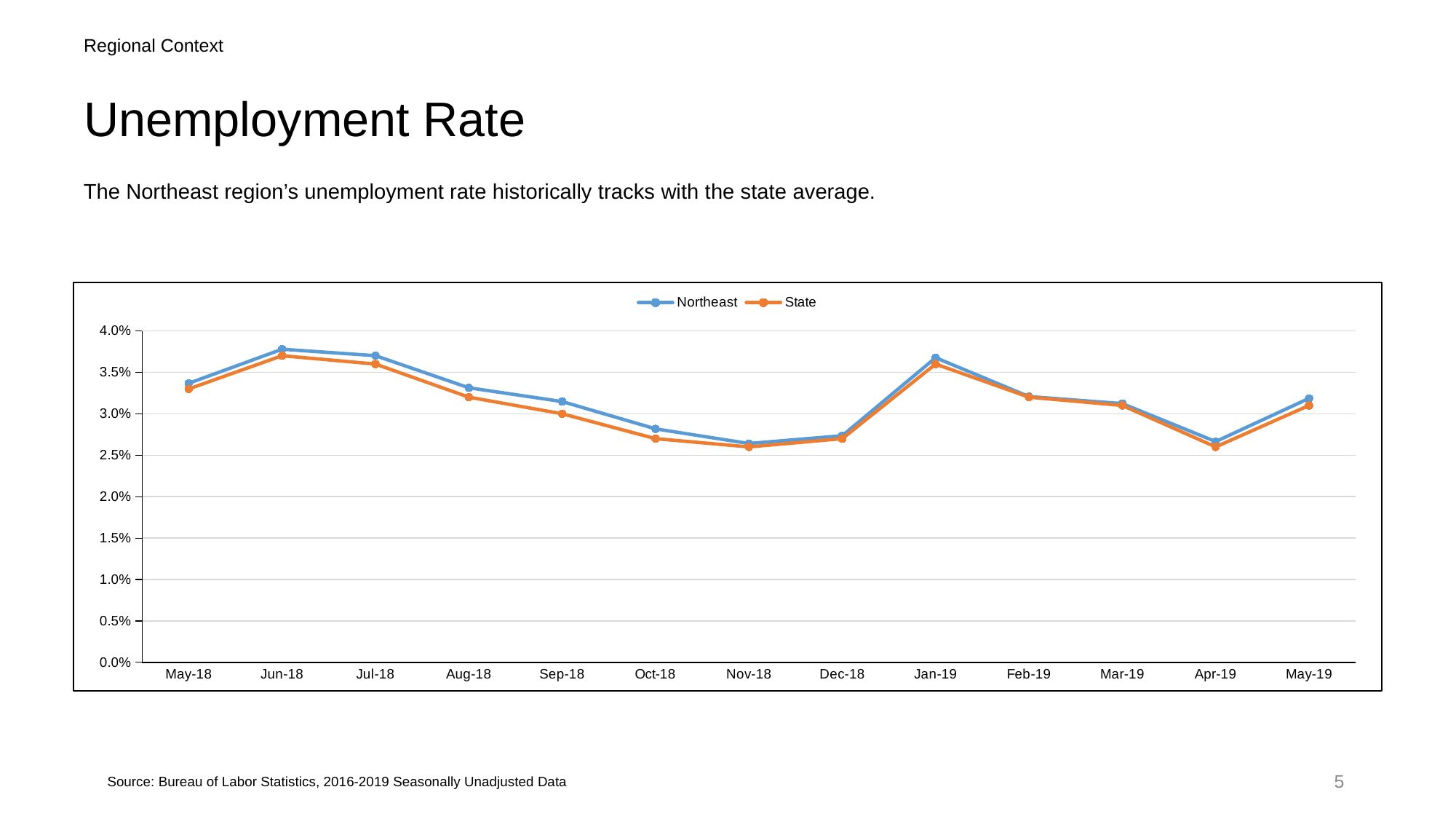
How many months are plotted along the x axis of the chart? 13 Is the Northeast value for Oct-18 greater or less than 3.0%? less Is the State value for Jan-19 greater or less than 3.0%? greater What kind of chart is shown on the slide? Line chart Is the Northeast value for Jun-18 greater or less than 3.5%? greater In Oct-18, which series has the higher value, Northeast or State? Northeast Which series are listed in the chart's legend? Northeast and State Does the Northeast series rise or fall from Jun-18 to Nov-18? Fall In which month does the Northeast series reach its highest value? Jun-18 In which month does the State series reach its highest value? Jun-18 How many series does the chart's legend list? 2